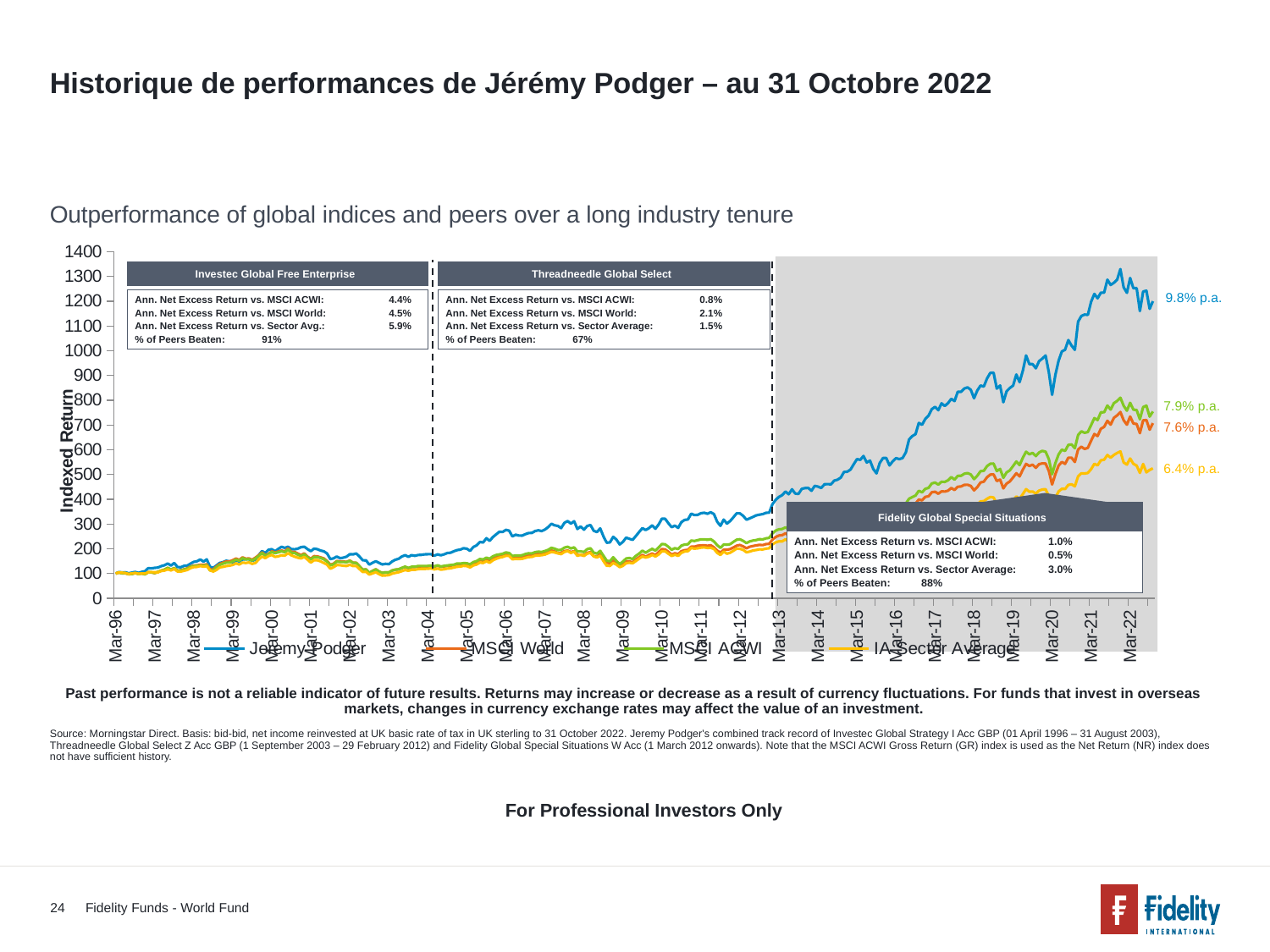
What annualised return is labelled next to the IA Sector Average line at the right of the chart? 6.4% p.a. According to the Investec Global Free Enterprise box on the chart, what is the % of Peers Beaten? 91% What kind of chart is shown on the slide? line chart Is the value of the IA Sector Average line at Mar-22 greater or less than 700? less Is the value of the Jeremy Podger line at Mar-22 greater or less than 1000? greater Does the Jeremy Podger line generally rise or fall from Mar-96 to Mar-22? rise How many series does the chart legend list? 4 What is the highest tick value shown on the vertical axis? 1400 Which series ends at the lowest indexed return at Mar-22? IA Sector Average What annualised return is labelled next to the Jeremy Podger line at the right of the chart? 9.8% p.a. Which series ends at the highest indexed return at Mar-22? Jeremy Podger What is the label on the vertical axis of the chart? Indexed Return